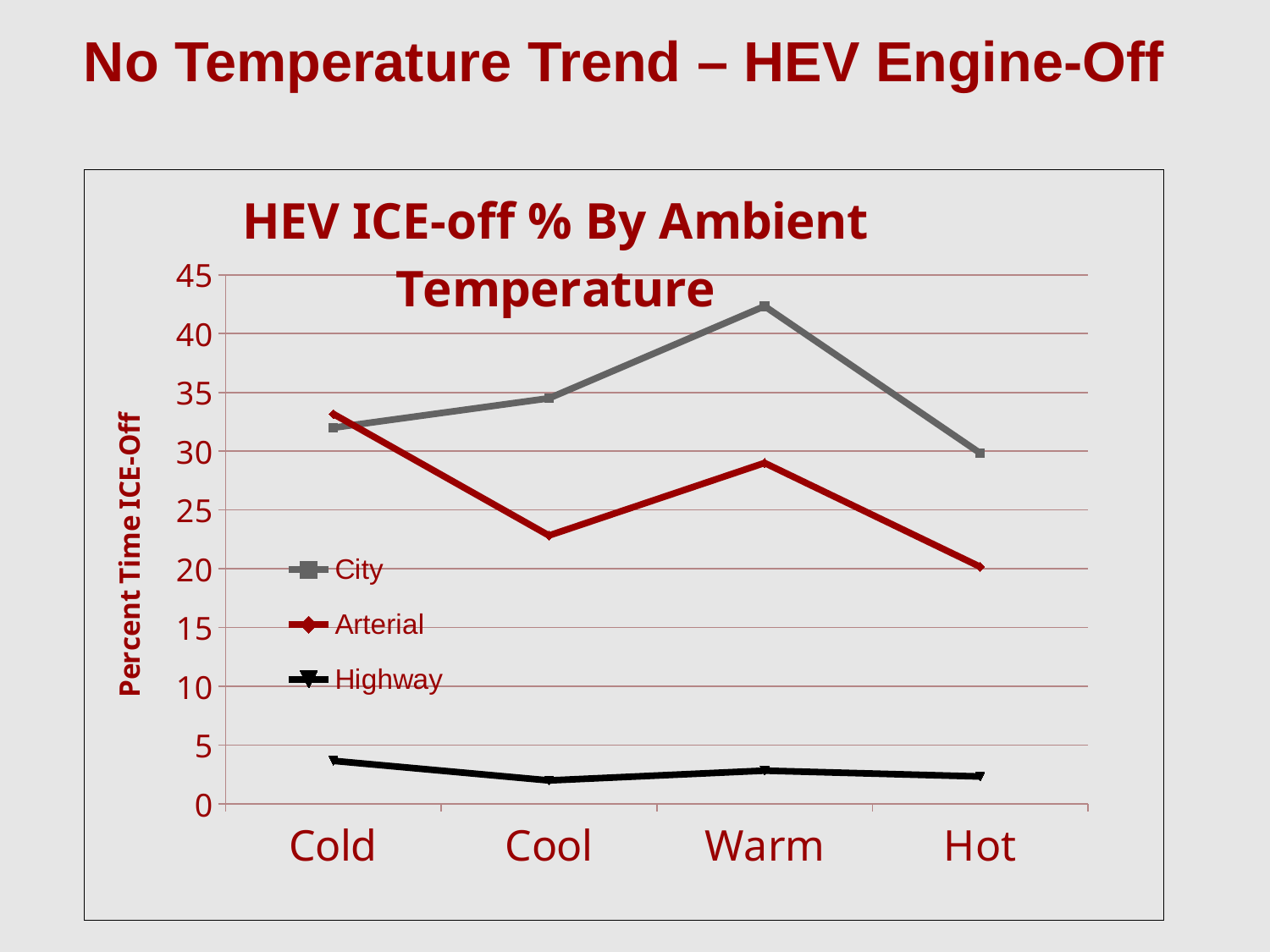
Is the City value for Warm greater or less than 40? greater What is the title of the chart? HEV ICE-off % By Ambient Temperature Is the Arterial value for Hot greater or less than 25? less How many temperature categories are shown on the x axis? 4 What kind of chart is shown on the slide? line chart Which series has the lowest values across all temperature categories? Highway For the City series, which temperature category has the highest value? Warm How many series does the legend list? 3 Which series is larger at Cool, City or Arterial? City For the Arterial series, which temperature category has the lowest value? Hot What is the label on the vertical axis? Percent Time ICE-Off Is the Highway value for Cold greater or less than 5? less